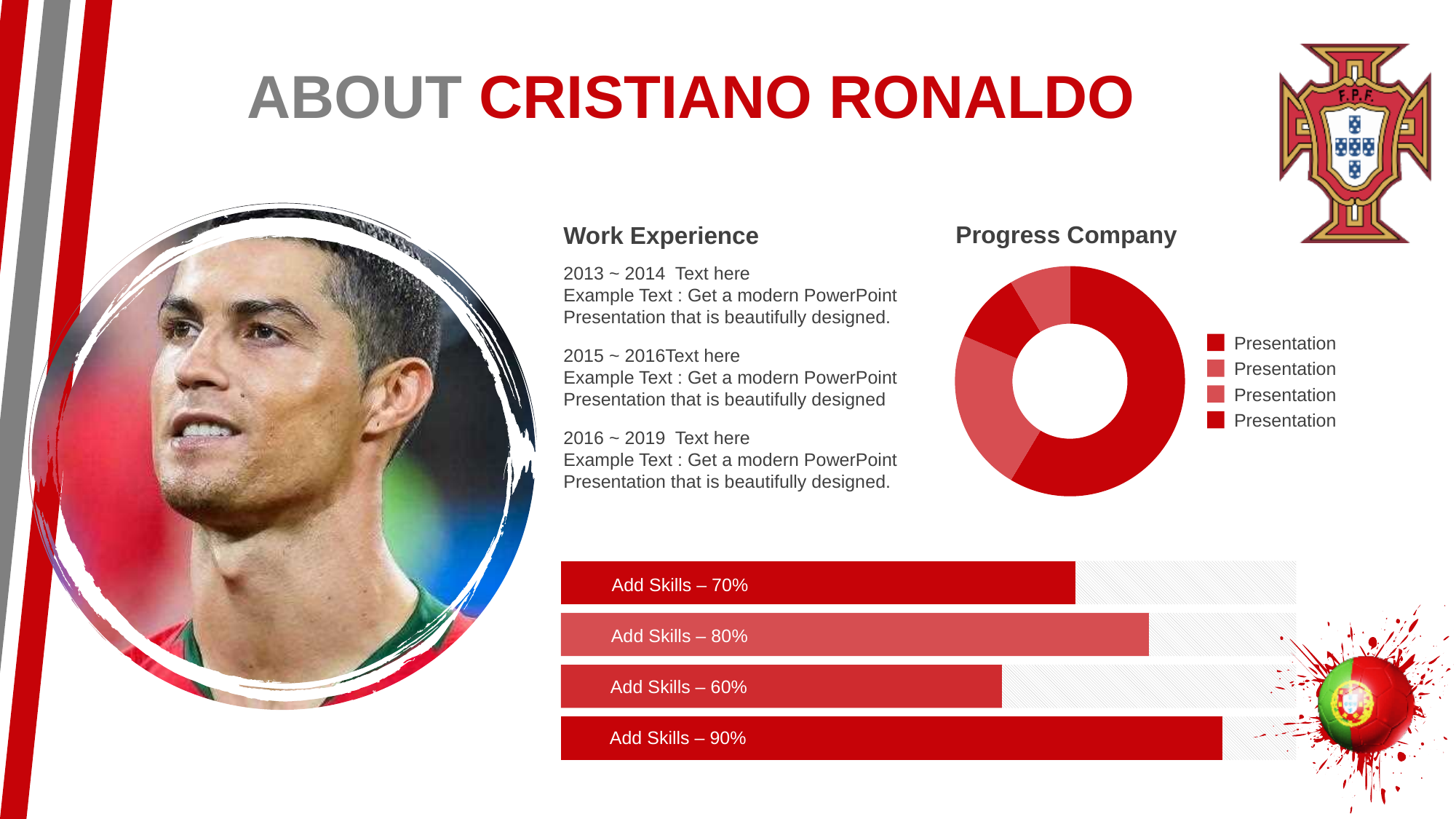
How many entries does the legend of the 'Progress Company' chart list? 4 What label is used for every legend entry of the 'Progress Company' chart? Presentation In the skill bars at the bottom right, what is the value of the second bar from the top? 80% What type of chart is the 'Progress Company' chart? Donut (pie) chart How many skill bars are shown at the bottom right of the slide? 4 In the skill bars at the bottom right, what is the value of the top bar? 70% In the skill bars at the bottom right, what is the difference between the highest and lowest values? 30 percentage points In the 'Progress Company' donut chart, does the largest slice take up more or less than half of the ring? More than half How many slices does the 'Progress Company' donut chart have? 4 In the skill bars at the bottom right, which bar has the lowest value? The third bar, 60% What is the title of the donut chart on the slide? Progress Company In the skill bars at the bottom right, which bar has the highest value? The bottom bar, 90%